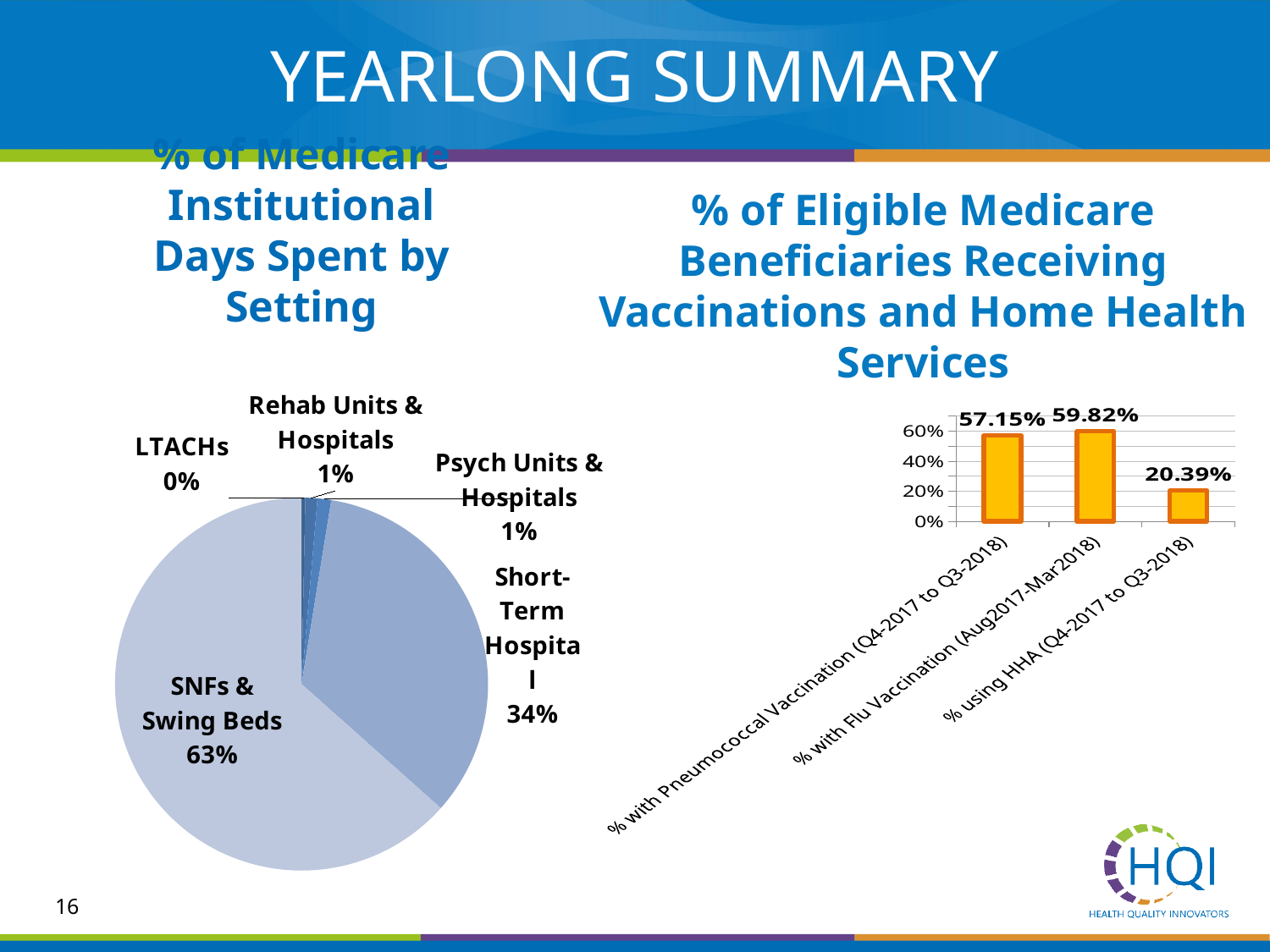
What kind of chart is the one on the left of the slide? Pie chart In the pie chart '% of Medicare Institutional Days Spent by Setting', what is the difference between the SNFs & Swing Beds share and the Short-Term Hospital share? 29% In the pie chart '% of Medicare Institutional Days Spent by Setting', what share of days is spent in LTACHs? 0% In the pie chart '% of Medicare Institutional Days Spent by Setting', what share of days is spent in Short-Term Hospital? 34% In the pie chart '% of Medicare Institutional Days Spent by Setting', how many slices (settings) are shown? 5 In the bar chart '% of Eligible Medicare Beneficiaries Receiving Vaccinations and Home Health Services', what is the difference between the Flu Vaccination value and the Pneumococcal Vaccination value? 2.67% In the pie chart '% of Medicare Institutional Days Spent by Setting', which setting has the largest share? SNFs & Swing Beds In the pie chart '% of Medicare Institutional Days Spent by Setting', what share of days is spent in SNFs & Swing Beds? 63% In the bar chart '% of Eligible Medicare Beneficiaries Receiving Vaccinations and Home Health Services', what is the value for % with Flu Vaccination (Aug2017-Mar2018)? 59.82% In the bar chart '% of Eligible Medicare Beneficiaries Receiving Vaccinations and Home Health Services', what is the value for % using HHA (Q4-2017 to Q3-2018)? 20.39% In the bar chart '% of Eligible Medicare Beneficiaries Receiving Vaccinations and Home Health Services', which category has the lowest value? % using HHA (Q4-2017 to Q3-2018) What kind of chart is the one on the right of the slide? Bar chart